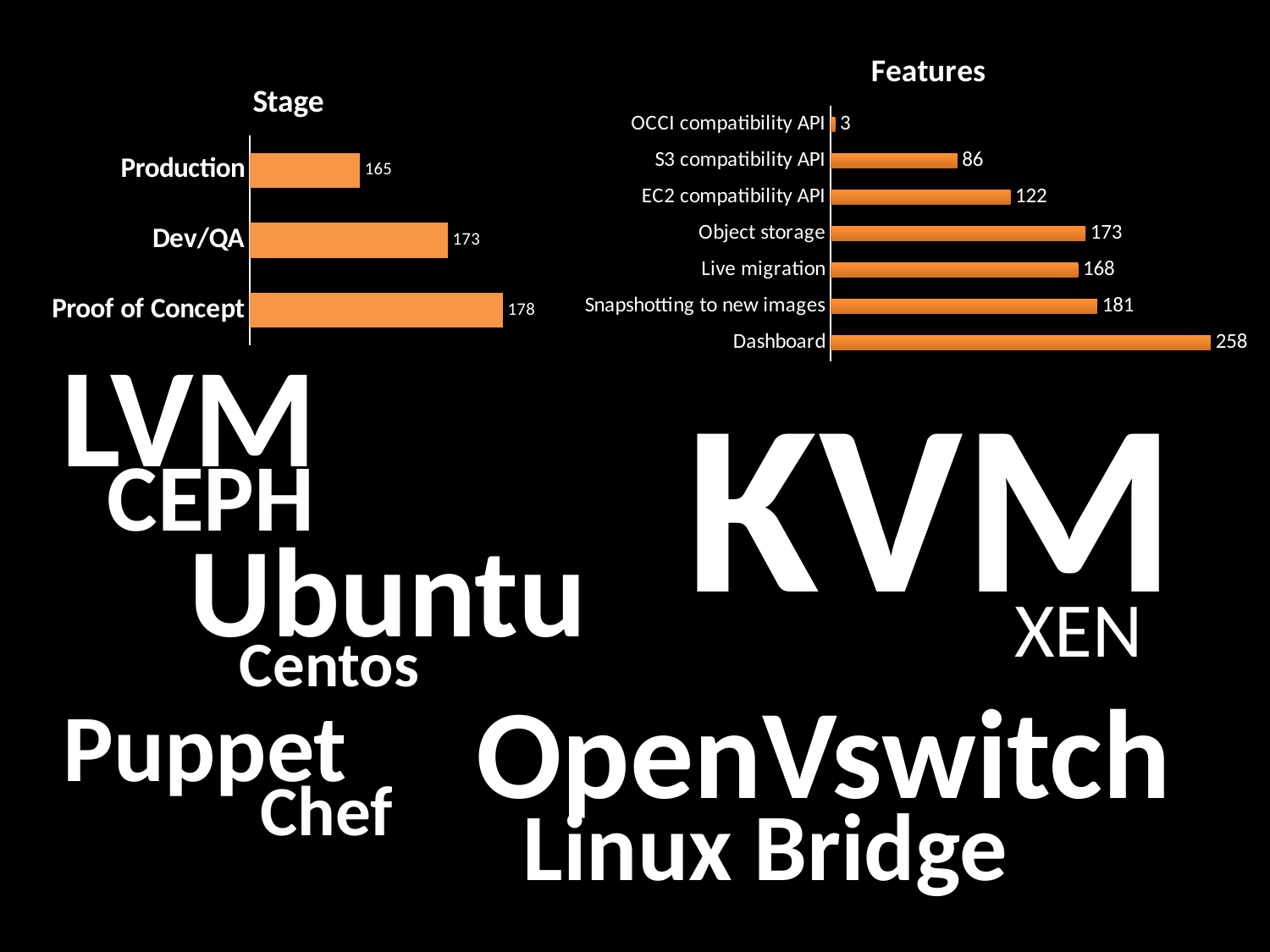
In the Features chart, which feature has the lowest value? OCCI compatibility API In the Features chart, how many features are listed? 7 In the Features chart, what is the difference between Dashboard and Snapshotting to new images? 77 In the Features chart, which feature has the highest value? Dashboard In the Features chart, what is the value for Live migration? 168 In the Stage chart, what is the value for Production? 165 In the Features chart, what is the value for S3 compatibility API? 86 In the Features chart, which is larger: EC2 compatibility API or Object storage? Object storage In the Stage chart, what is the difference between Proof of Concept and Production? 13 What type of chart is the Features chart? Bar chart In the Stage chart, which stage has the highest value? Proof of Concept In the Stage chart, how many stages are shown? 3